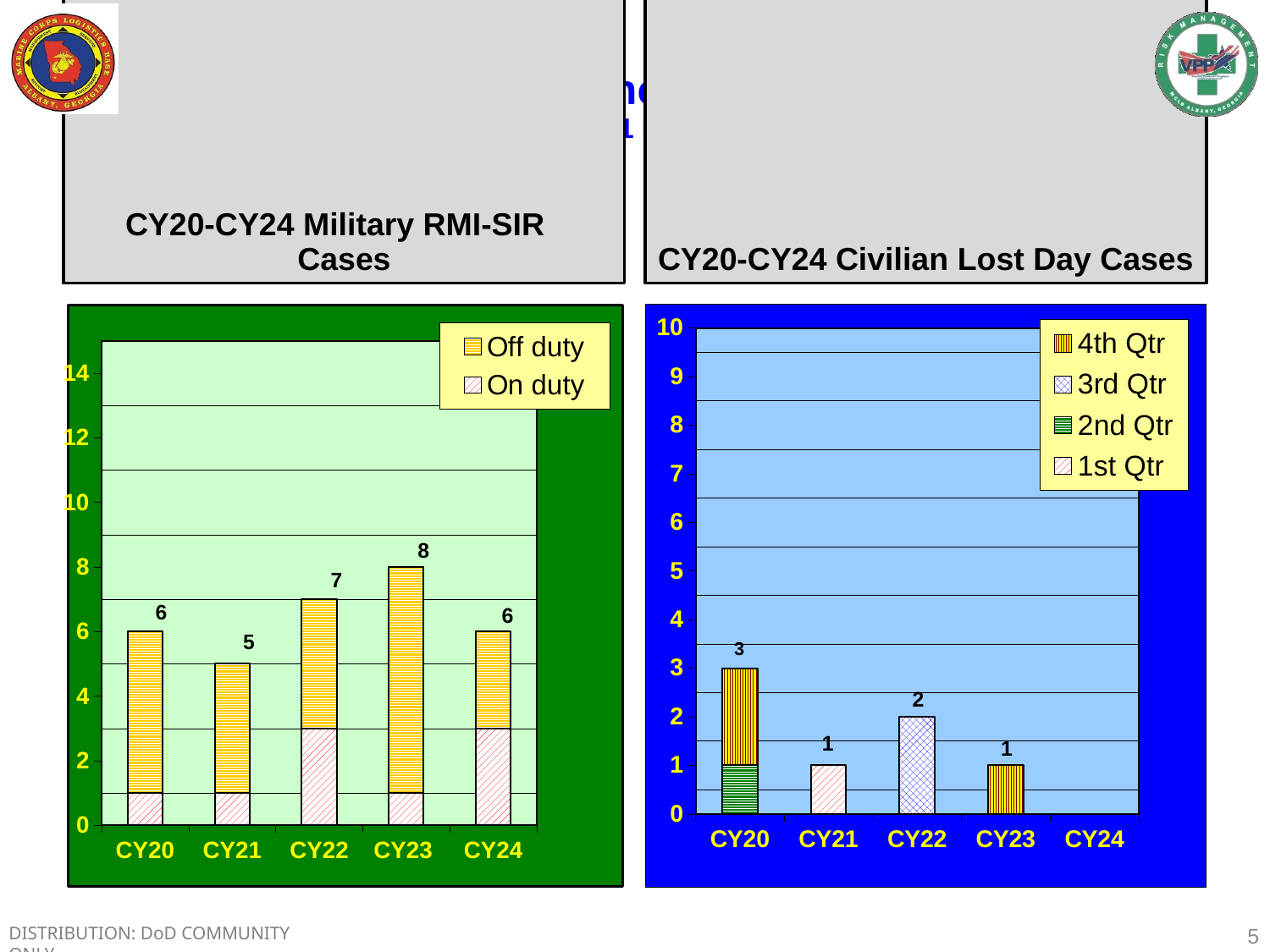
On the CY20-CY24 Military RMI-SIR Cases chart, is the total for CY22 greater or less than 10? less On the CY20-CY24 Military RMI-SIR Cases chart, which year has the highest total? CY23 On the CY20-CY24 Military RMI-SIR Cases chart, what kind of chart is shown? Stacked bar chart On the CY20-CY24 Military RMI-SIR Cases chart, how many series does the legend list? 2 On the CY20-CY24 Civilian Lost Day Cases chart, which year has the highest total? CY20 On the CY20-CY24 Civilian Lost Day Cases chart, how many years are shown on the x axis? 5 On the CY20-CY24 Civilian Lost Day Cases chart, what is the total for CY20? 3 On the CY20-CY24 Military RMI-SIR Cases chart, which year has the lowest total? CY21 On the CY20-CY24 Civilian Lost Day Cases chart, which is larger, the total for CY22 or the total for CY23? CY22 On the CY20-CY24 Civilian Lost Day Cases chart, how many series does the legend list? 4 On the CY20-CY24 Military RMI-SIR Cases chart, what is the difference between the CY23 total and the CY21 total? 3 On the CY20-CY24 Military RMI-SIR Cases chart, what is the total number of cases for CY23? 8